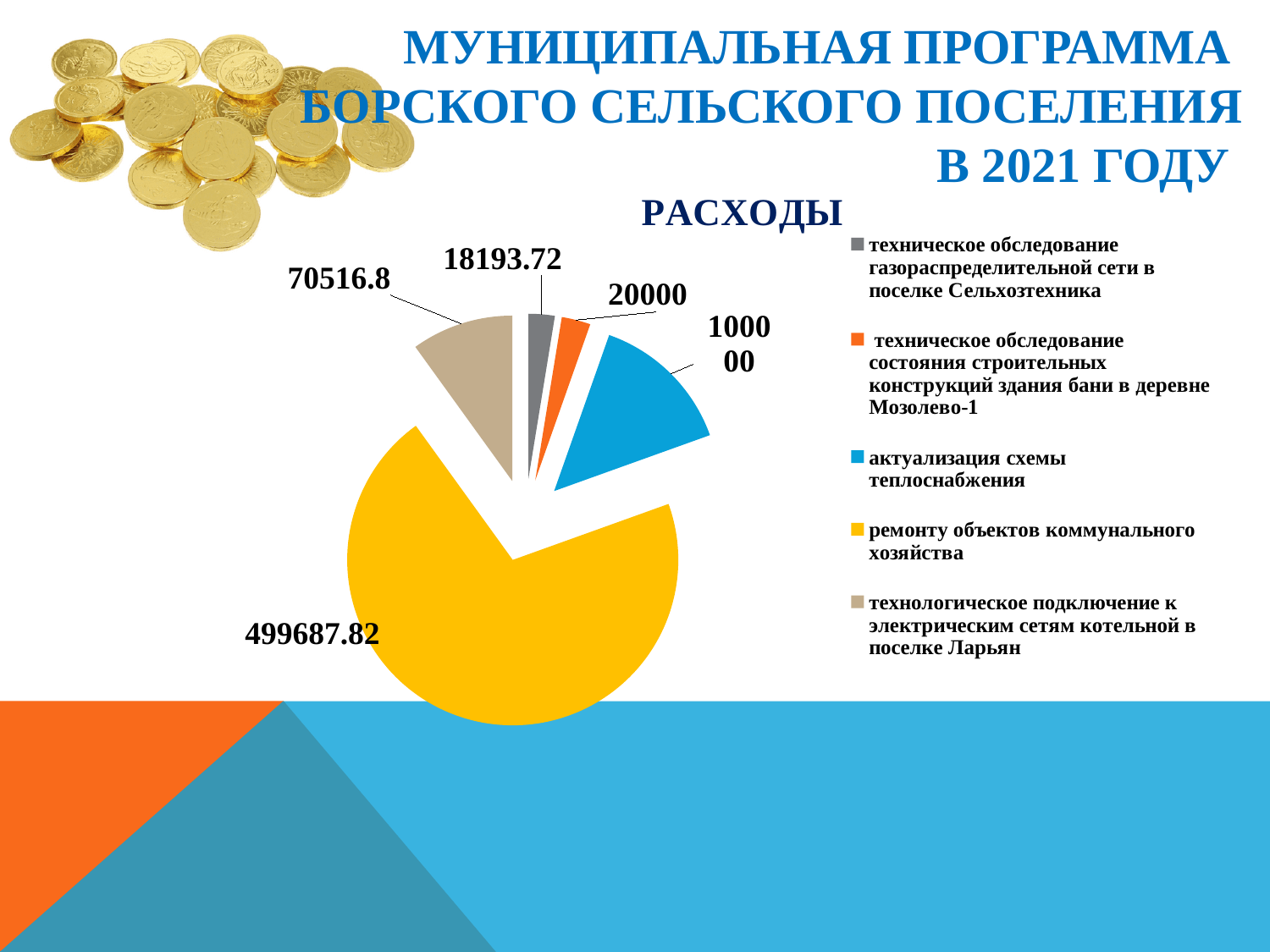
How many slices does the pie chart have? 5 Which is larger: the value for "актуализация схемы теплоснабжения" or the value for "технологическое подключение к электрическим сетям котельной в поселке Ларьян"? актуализация схемы теплоснабжения What is the value for "техническое обследование состояния строительных конструкций здания бани в деревне Мозолево-1"? 20000 What is the value for "технологическое подключение к электрическим сетям котельной в поселке Ларьян"? 70516.8 What is the difference between the values for "ремонту объектов коммунального хозяйства" and "технологическое подключение к электрическим сетям котельной в поселке Ларьян"? 429171.02 What is the value for "ремонту объектов коммунального хозяйства"? 499687.82 How many entries does the legend list? 5 What is the value for "техническое обследование газораспределительной сети в поселке Сельхозтехника"? 18193.72 What is the title of the chart? РАСХОДЫ Which category has the smallest slice of the pie? техническое обследование газораспределительной сети в поселке Сельхозтехника Which category has the largest slice of the pie? ремонту объектов коммунального хозяйства What kind of chart is shown on the slide? pie chart